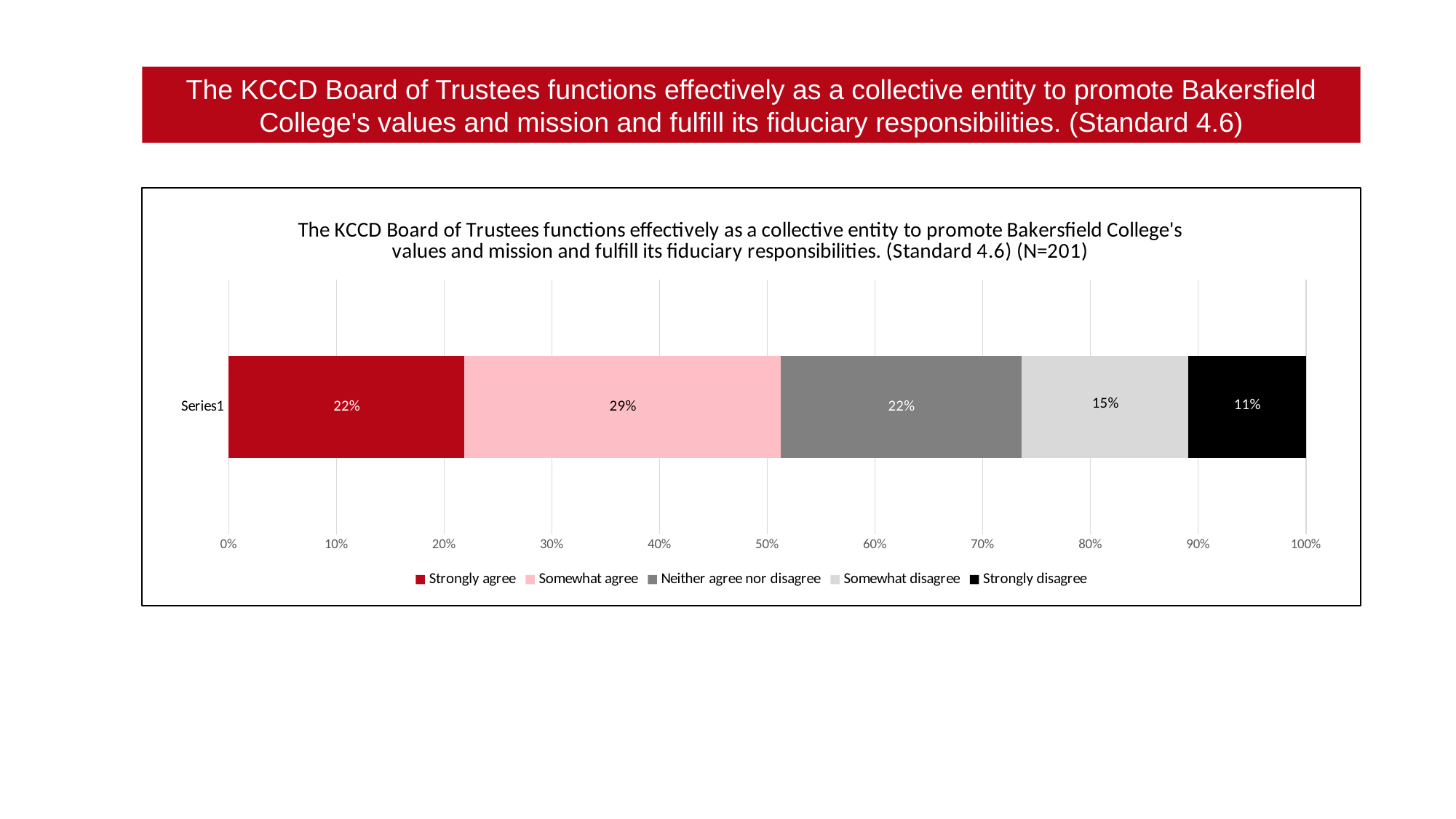
Which response option has the largest share? Somewhat agree What kind of chart is shown? Stacked bar chart What is the difference between the "Somewhat agree" and "Strongly disagree" percentages? 18% What percentage of respondents selected "Neither agree nor disagree"? 22% What percentage of respondents selected "Somewhat disagree"? 15% How many series does the legend list? 5 Which is larger, the share for "Somewhat disagree" or the share for "Strongly disagree"? Somewhat disagree What is the sample size (N) stated in the chart title? 201 What percentage of respondents selected "Strongly disagree"? 11% Which response option has the smallest share? Strongly disagree What is the combined percentage of "Strongly agree" and "Somewhat agree"? 51% What percentage of respondents selected "Somewhat agree"? 29%